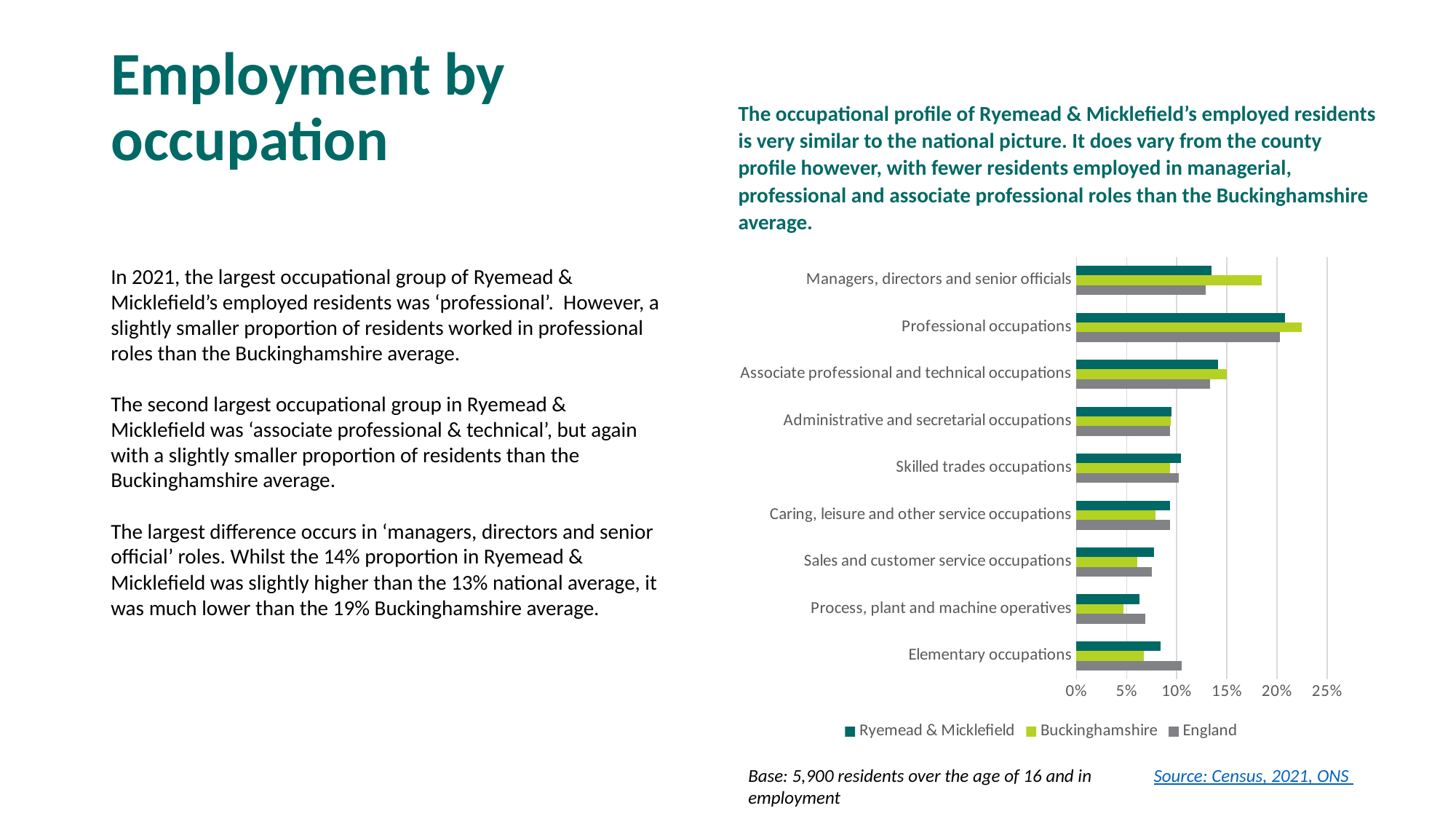
Which occupational category has the highest value for Ryemead & Micklefield? Professional occupations For Professional occupations, which is larger: the Buckinghamshire value or the England value? Buckinghamshire Is the Buckinghamshire value for Professional occupations greater or less than 20%? greater What kind of chart is shown on the slide? bar chart How many series does the chart legend list? 3 Which occupational category has the lowest value for Ryemead & Micklefield? Process, plant and machine operatives Which occupational category has the lowest value for Buckinghamshire? Process, plant and machine operatives Is the Ryemead & Micklefield value for Sales and customer service occupations greater or less than 10%? less How many occupational categories are plotted in the chart? 9 For Managers, directors and senior officials, which is larger: the Ryemead & Micklefield value or the Buckinghamshire value? Buckinghamshire Which three series are listed in the chart legend? Ryemead & Micklefield, Buckinghamshire, England